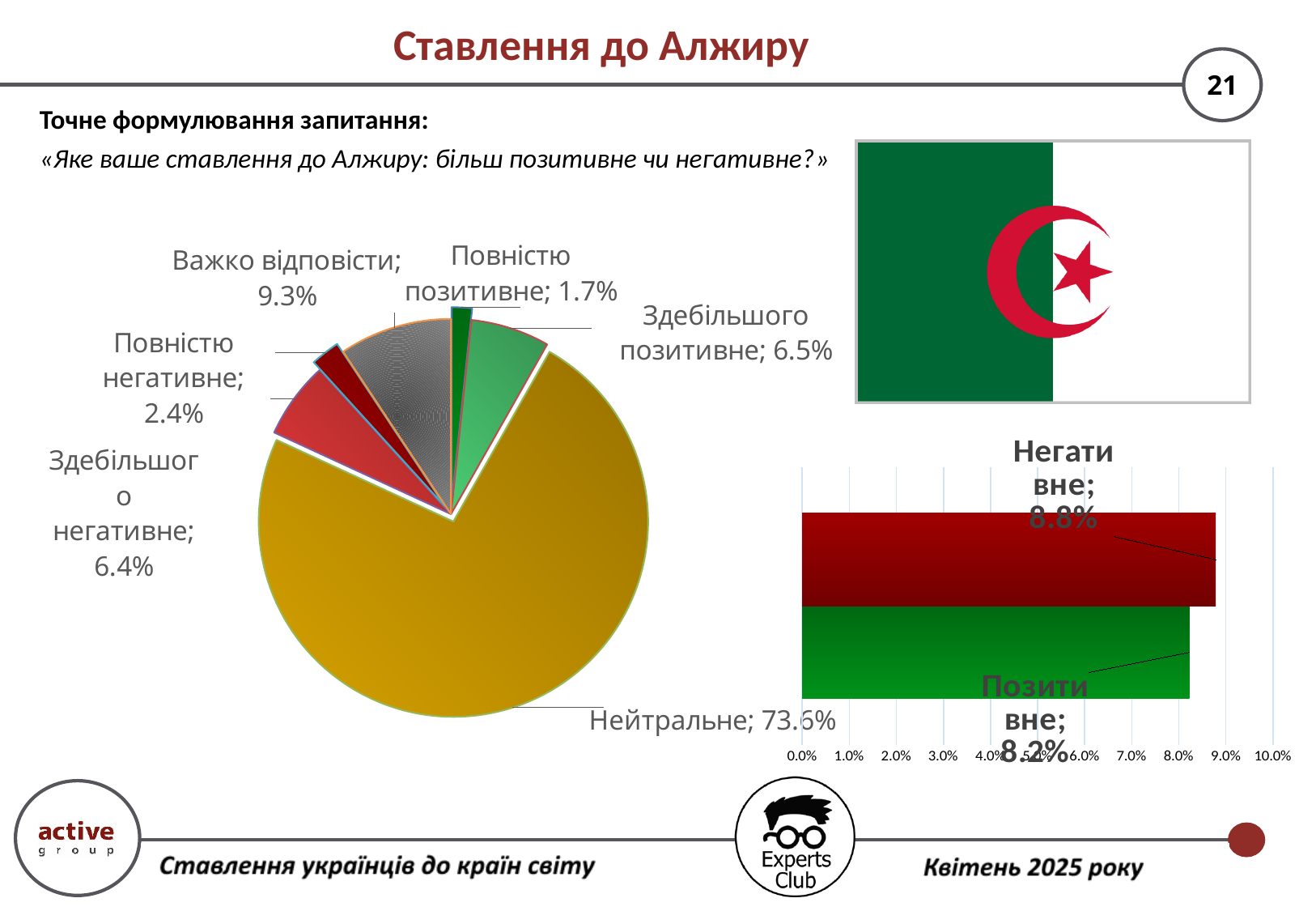
In the pie chart on the left, which category has the largest slice? Нейтральне What type of chart is shown in the bottom right of the slide? Bar chart In the bar chart on the right, what is the value for "Негативне"? 8.8% In the pie chart on the left, what is the value for "Важко відповісти"? 9.3% In the pie chart on the left, what is the difference between "Здебільшого позитивне" and "Здебільшого негативне"? 0.1% In the pie chart on the left, which is larger: "Важко відповісти" or "Повністю негативне"? Важко відповісти In the pie chart on the left, which category has the smallest slice? Повністю позитивне In the pie chart on the left, what share is labelled for "Нейтральне"? 73.6% What is the title of the slide? Ставлення до Алжиру How many categories does the pie chart on the left show? 6 In the pie chart on the left, what is the value for "Повністю позитивне"? 1.7% In the bar chart on the right, what is the difference between "Негативне" and "Позитивне"? 0.6%